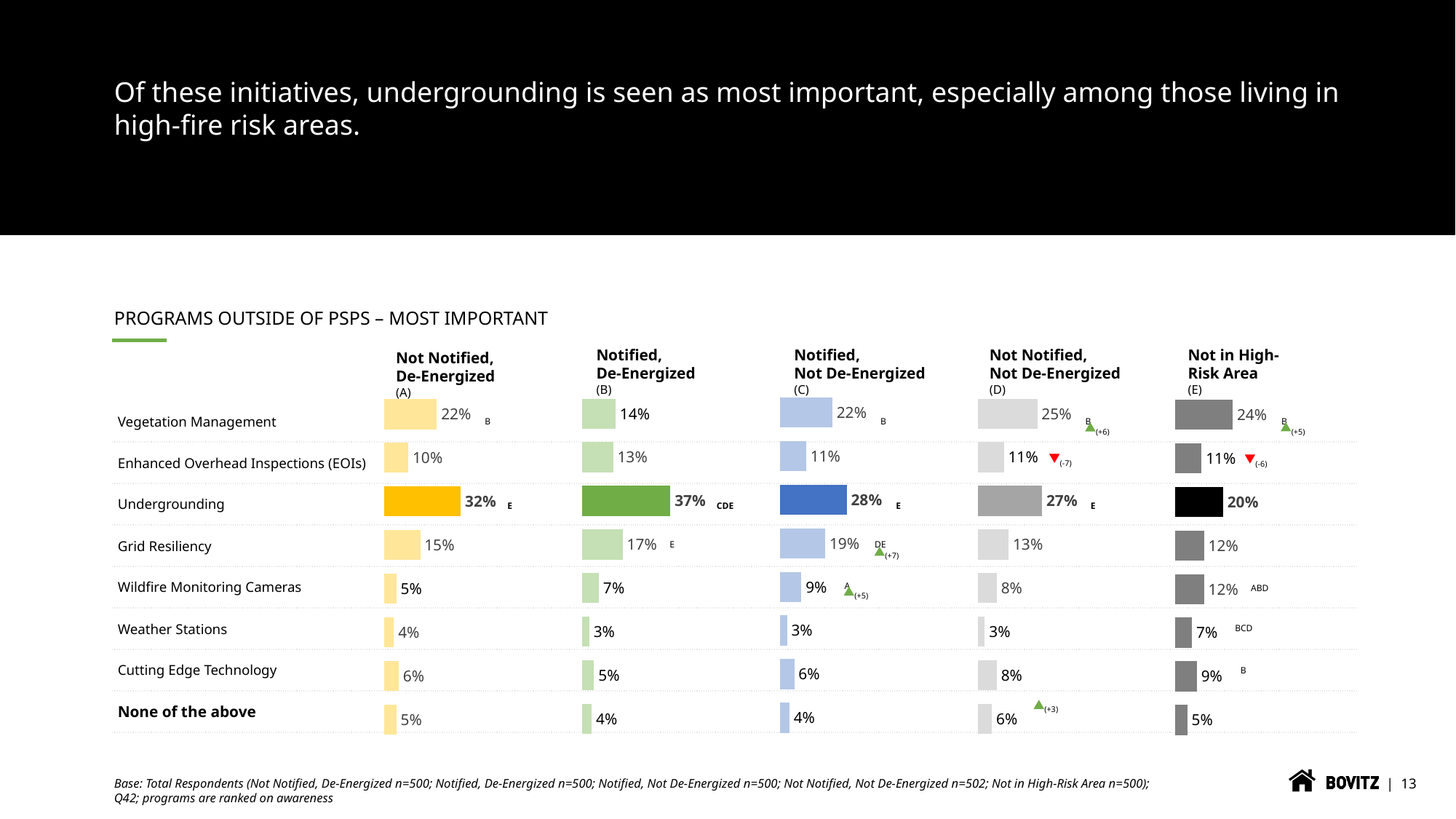
In the Not in High-Risk Area chart, what is the difference between Wildfire Monitoring Cameras and Weather Stations? 5 percentage points How many categories are shown in each chart? 8 In the Notified, De-Energized chart, what is the value for Undergrounding? 37% In the Not Notified, Not De-Energized chart, which category has the highest value? Undergrounding What is the title of the chart section on the slide? PROGRAMS OUTSIDE OF PSPS – MOST IMPORTANT In the Not Notified, Not De-Energized chart, what is the value for None of the above? 6% In the Not in High-Risk Area chart, which category has the lowest value? None of the above In the Not Notified, De-Energized chart, what is the difference between Undergrounding and Vegetation Management? 10 percentage points In the Notified, Not De-Energized chart, what is the value for Grid Resiliency? 19% In the Notified, De-Energized chart, which is larger: Grid Resiliency or Enhanced Overhead Inspections (EOIs)? Grid Resiliency What kind of chart is used to show the Not Notified, De-Energized results? Bar chart In the Not in High-Risk Area chart, what is the value for Vegetation Management? 24%